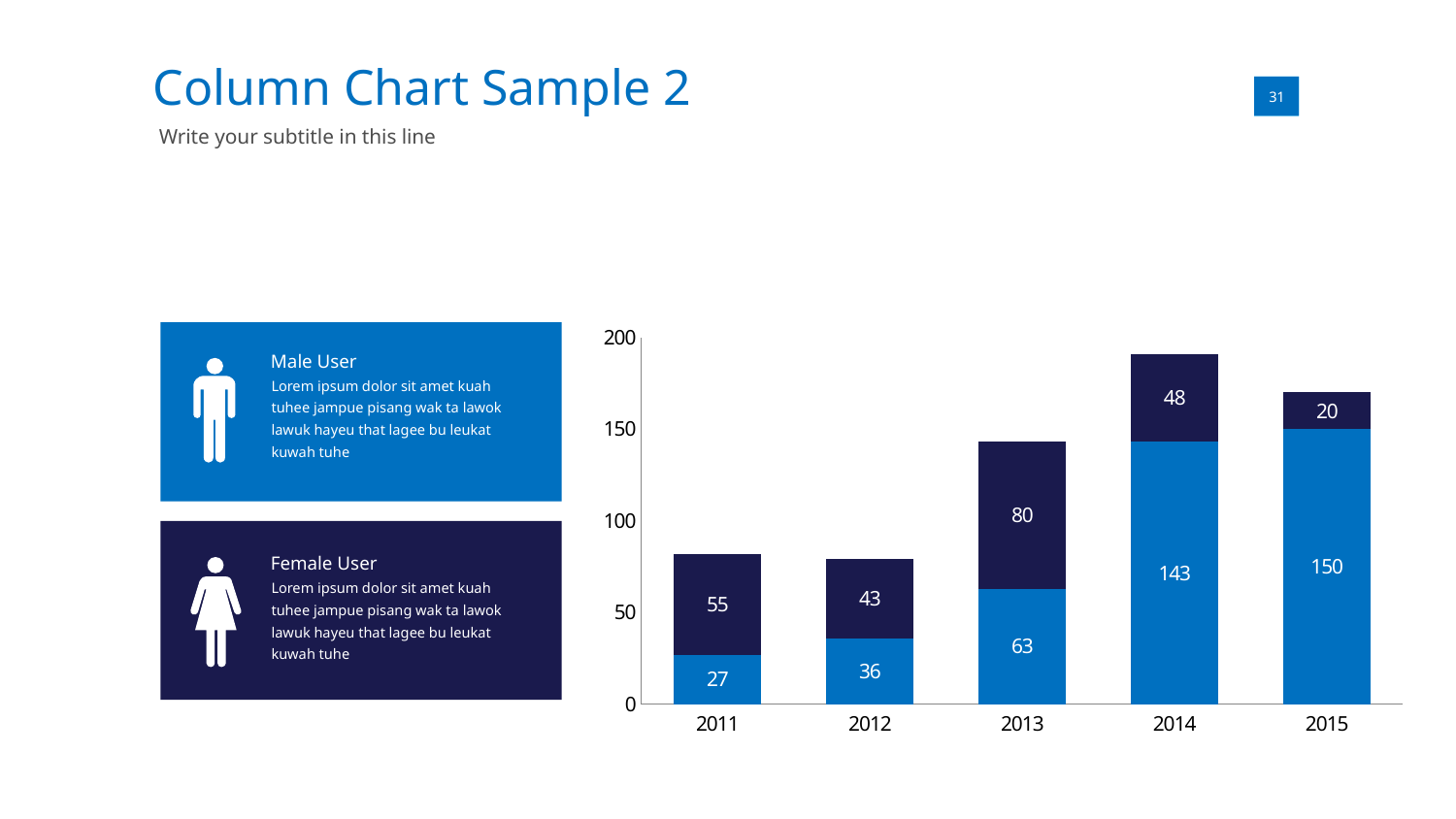
What is the Male User (light blue) value for 2014? 143 In which year is the Male User (light blue) value the highest? 2015 How many years are shown on the x axis of the chart? 5 What is the total of the stacked bar for 2011? 82 Do the Male User (light blue) values rise or fall from 2011 to 2015? Rise What is the total of the stacked bar for 2014? 191 What kind of chart is shown on the slide? Stacked bar chart Is the total height of the 2013 bar greater or less than 100? greater In which year is the Female User (dark blue) value the lowest? 2015 What is the difference between the Male User values for 2015 and 2014? 7 Which year has the larger Female User (dark blue) value, 2011 or 2012? 2011 What is the Female User (dark blue) value for 2013? 80